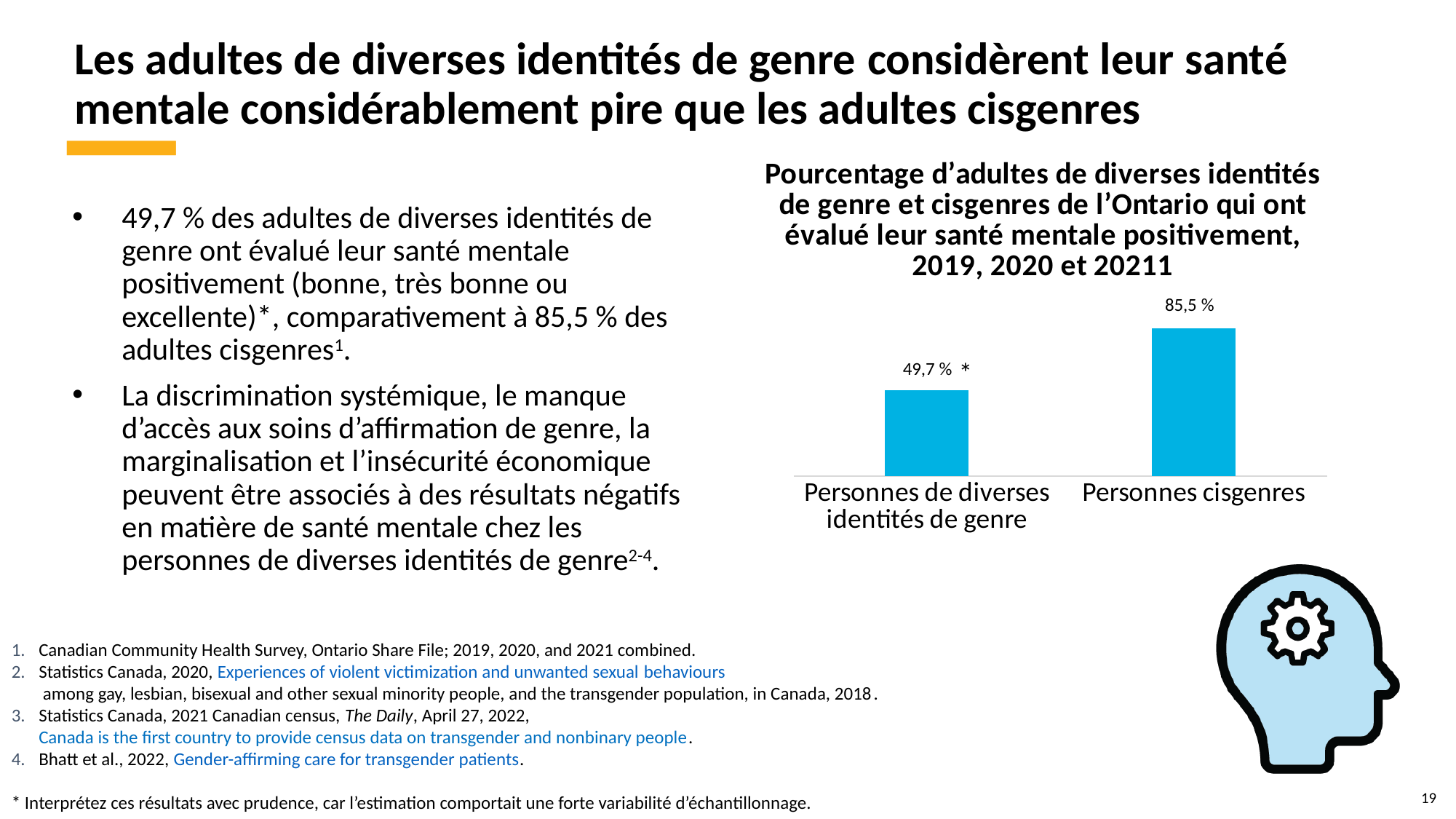
How many categories are shown in the chart? 2 What colour are the bars in the chart? blue Which category has the higher value in the chart? Personnes cisgenres What percentage of 'Personnes de diverses identités de genre' rated their mental health positively? 49,7 % Is the value for 'Personnes cisgenres' larger or smaller than the value for 'Personnes de diverses identités de genre'? larger What percentage of 'Personnes cisgenres' rated their mental health positively? 85,5 % Which category's data label is marked with an asterisk? Personnes de diverses identités de genre Which category has the lower value in the chart? Personnes de diverses identités de genre What type of chart is shown on the slide? bar chart What is the difference in percentage points between 'Personnes cisgenres' and 'Personnes de diverses identités de genre'? 35,8